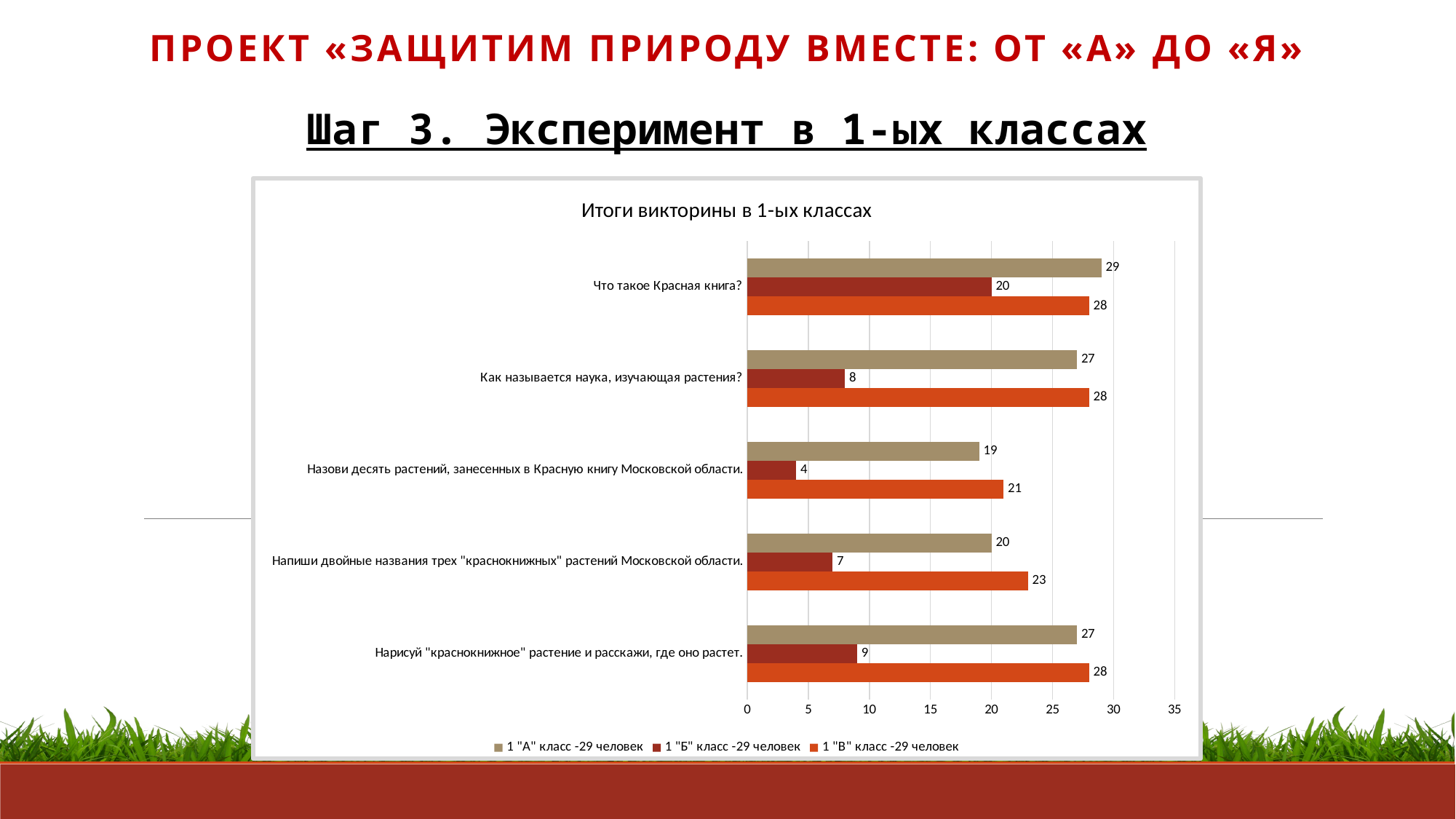
How many questions (categories) are shown on the chart? 5 Which question has the highest value for 1 "А" класс? Что такое Красная книга? What is the difference between 1 "В" класс and 1 "Б" класс on "Нарисуй "краснокнижное" растение и расскажи, где оно растет."? 19 What kind of chart is shown on the slide? bar chart What is the value for 1 "В" класс on "Напиши двойные названия трех "краснокнижных" растений Московской области."? 23 What is the value for 1 "Б" класс on "Как называется наука, изучающая растения?"? 8 How many series does the legend list? 3 Which question has the lowest value for 1 "Б" класс? Назови десять растений, занесенных в Красную книгу Московской области. Is the value for 1 "Б" класс on "Что такое Красная книга?" greater or less than 15? greater What is the title of the chart? Итоги викторины в 1-ых классах Which is larger on "Назови десять растений, занесенных в Красную книгу Московской области.": 1 "А" класс or 1 "В" класс? 1 "В" класс What is the value for 1 "А" класс on "Что такое Красная книга?"? 29